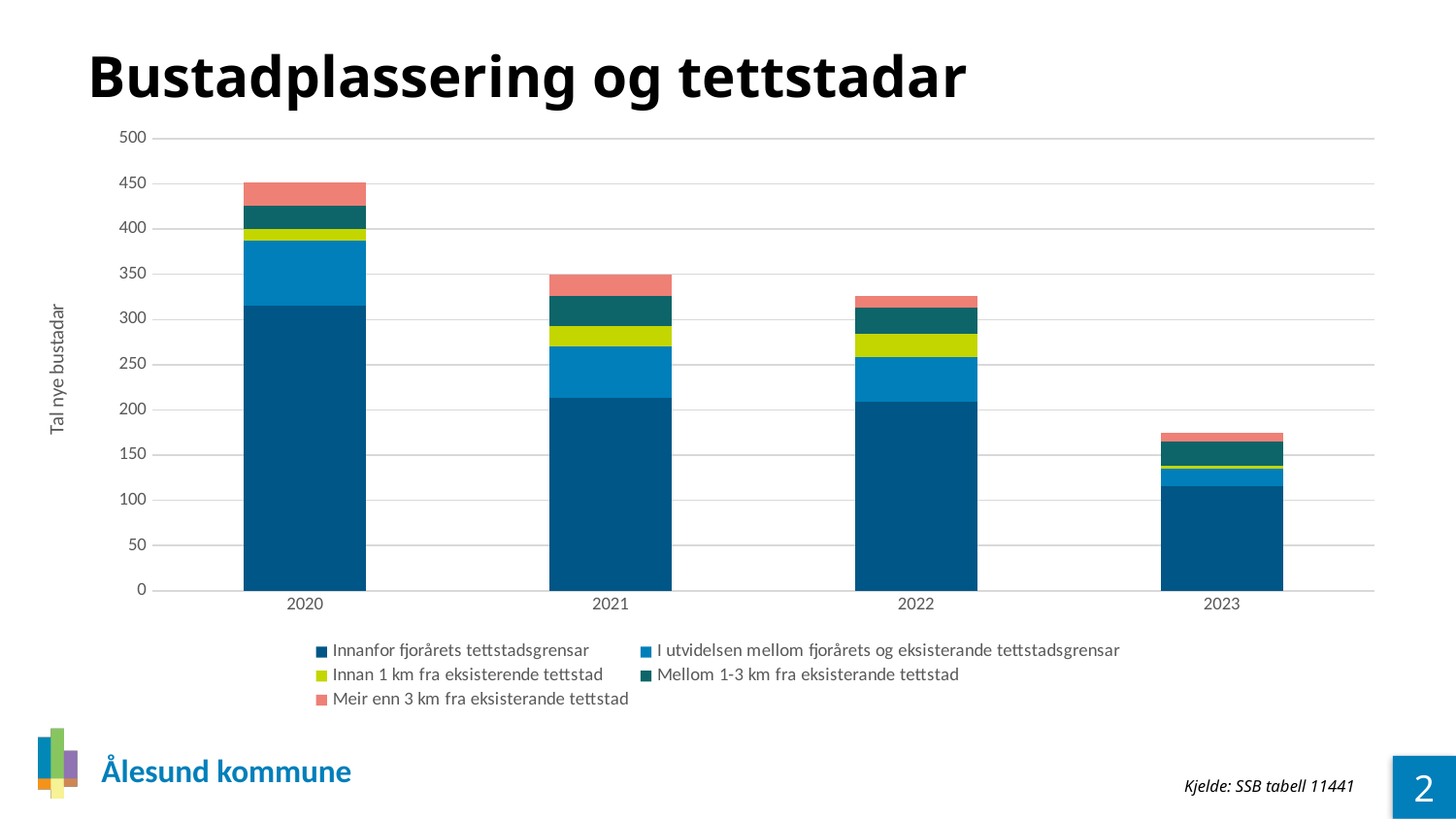
Which year has the lowest total number of new dwellings? 2023 Which year has a larger total bar, 2020 or 2023? 2020 Is the total value for 2021 greater or less than 300? greater What kind of chart is shown on the slide? bar chart Which year has the highest total number of new dwellings? 2020 How many series does the chart's legend list? 5 Is the 'Innanfor fjorårets tettstadsgrensar' segment for 2020 greater or less than 300? greater What is the label on the vertical axis of the chart? Tal nye bustadar Is the total value for 2020 greater or less than 400? greater How many years are shown on the x axis of the chart? 4 Do the total bar heights rise or fall from 2020 to 2023? fall